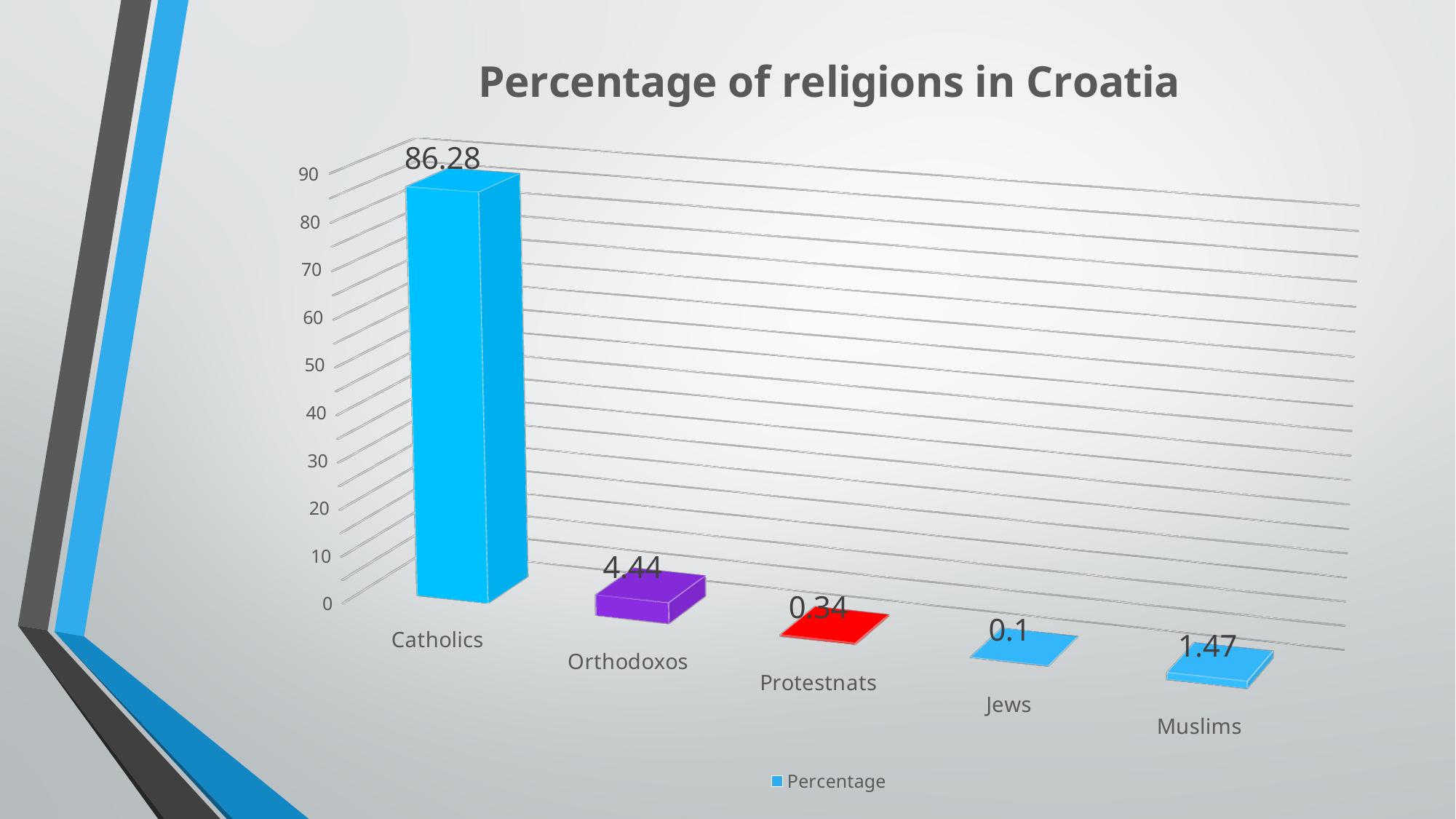
What is the value for Muslims? 1.47 What is the difference between the values for Catholics and Orthodoxos? 81.84 What is the value for Orthodoxos? 4.44 Which category has the highest value? Catholics What is the value for Protestnats? 0.34 Which category has the lowest value? Jews What is the value for Catholics? 86.28 How many categories are shown on the chart? 5 What kind of chart is shown on the slide? Bar chart What is the title of the chart? Percentage of religions in Croatia Which is larger, the value for Muslims or the value for Protestnats? Muslims What is the value for Jews? 0.1